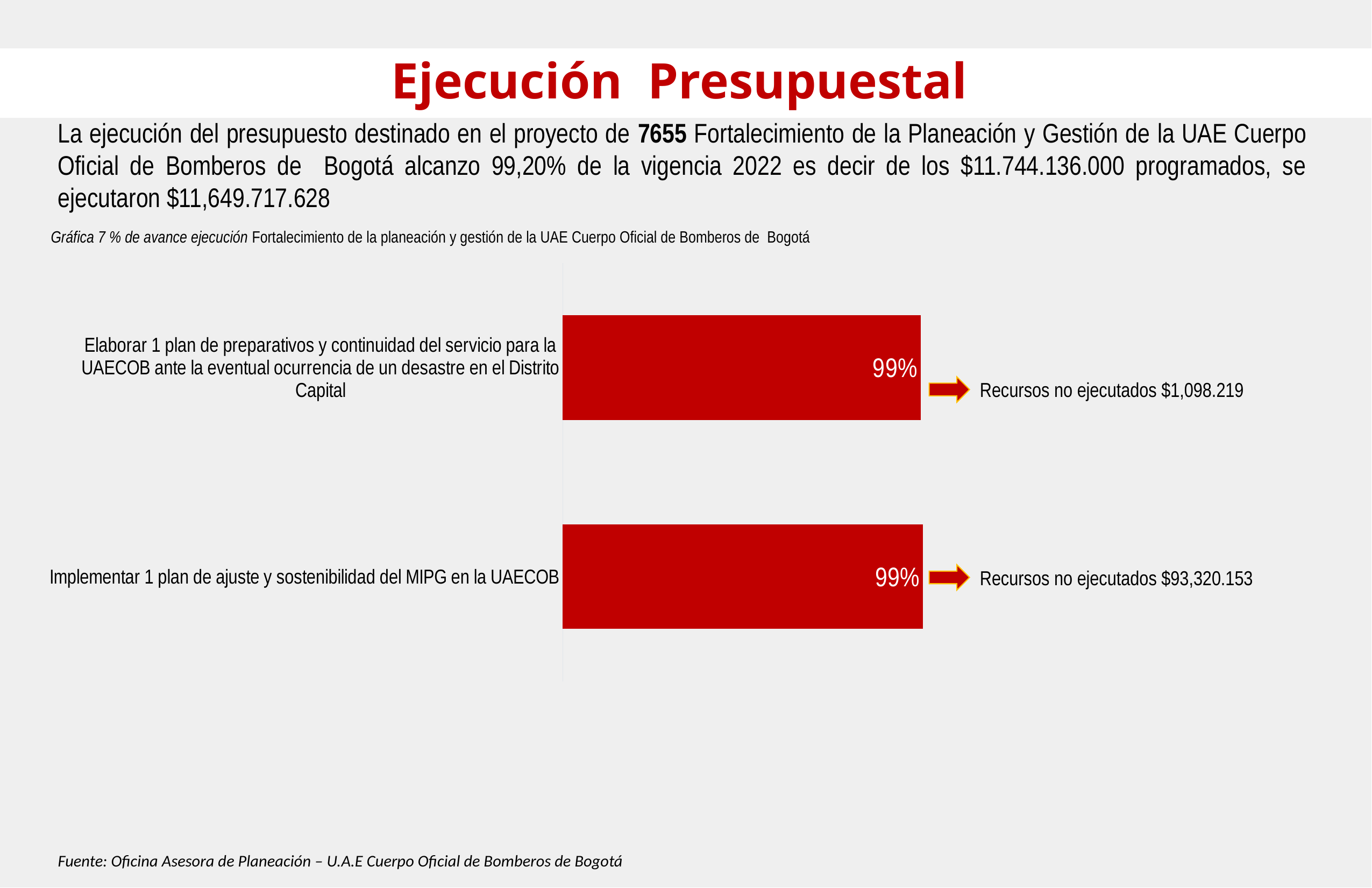
What is the value shown for "Implementar 1 plan de ajuste y sostenibilidad del MIPG en la UAECOB"? 99% Are the bars in the chart horizontal or vertical? horizontal What is the difference between the value for "Implementar 1 plan de ajuste y sostenibilidad del MIPG en la UAECOB" and the value for "Elaborar 1 plan de preparativos y continuidad del servicio..."? 0% What kind of chart is shown on the slide? bar chart How many bars does the chart show? 2 What colour are the bars in the chart? red Do both bars in the chart show the same value? yes What is the value shown for "Elaborar 1 plan de preparativos y continuidad del servicio para la UAECOB ante la eventual ocurrencia de un desastre en el Distrito Capital"? 99%